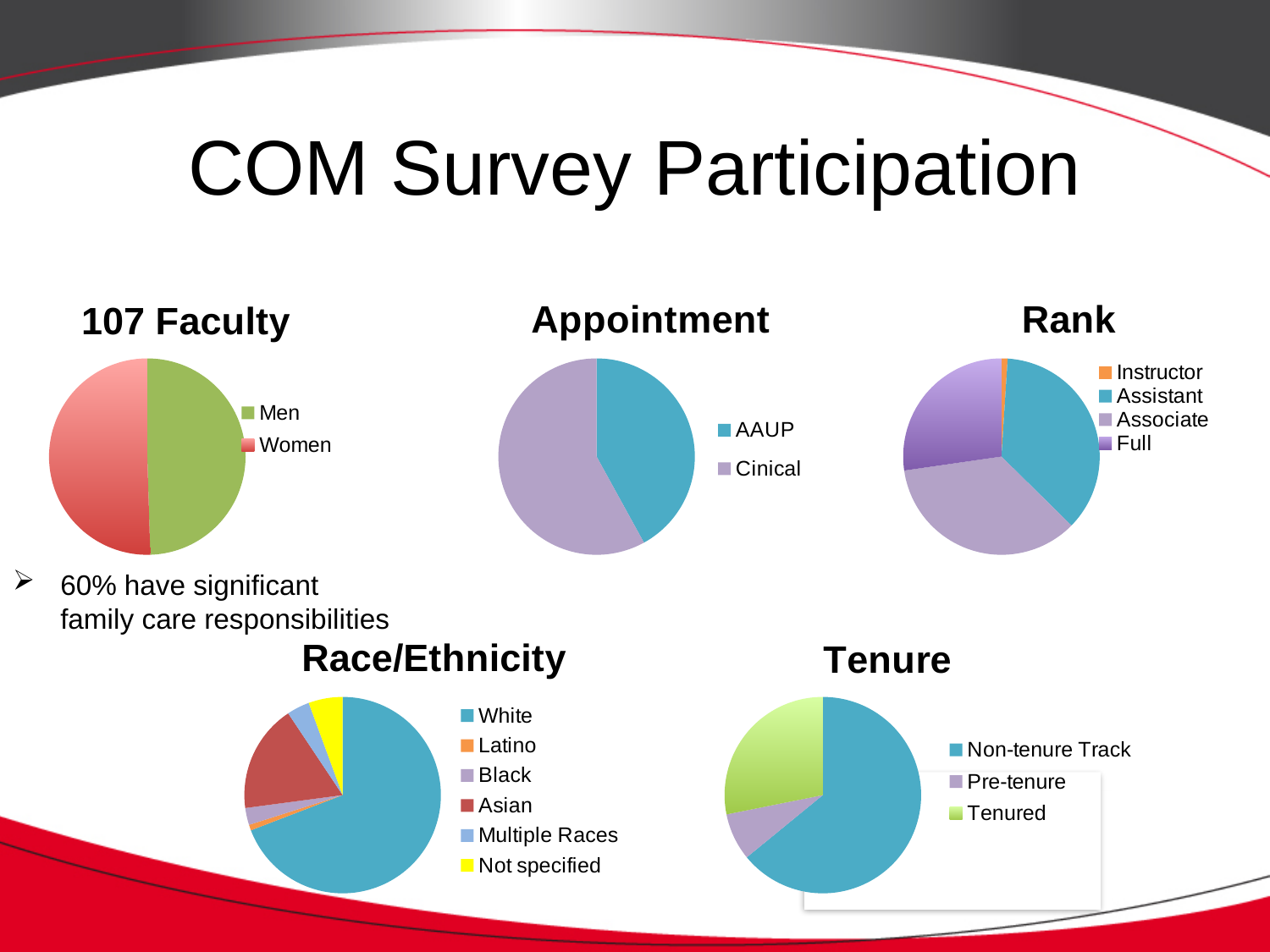
In the "Appointment" chart, which category has the larger slice, AAUP or Cinical? Cinical How many categories does the legend of the "Tenure" chart list? 3 In the "Race/Ethnicity" chart, which category has the largest slice? White How many categories does the legend of the "Rank" chart list? 4 What kind of chart is the "107 Faculty" chart? pie chart In the "Race/Ethnicity" chart, which slice is larger, White or Asian? White In the "Tenure" chart, which category has the smallest slice? Pre-tenure What colour is the "Not specified" slice in the "Race/Ethnicity" chart? yellow In the "Rank" chart, which category has the smallest slice? Instructor In the "Rank" chart, which slice is larger, Full or Instructor? Full In the "Tenure" chart, which category has the largest slice? Non-tenure Track How many categories does the legend of the "Race/Ethnicity" chart list? 6